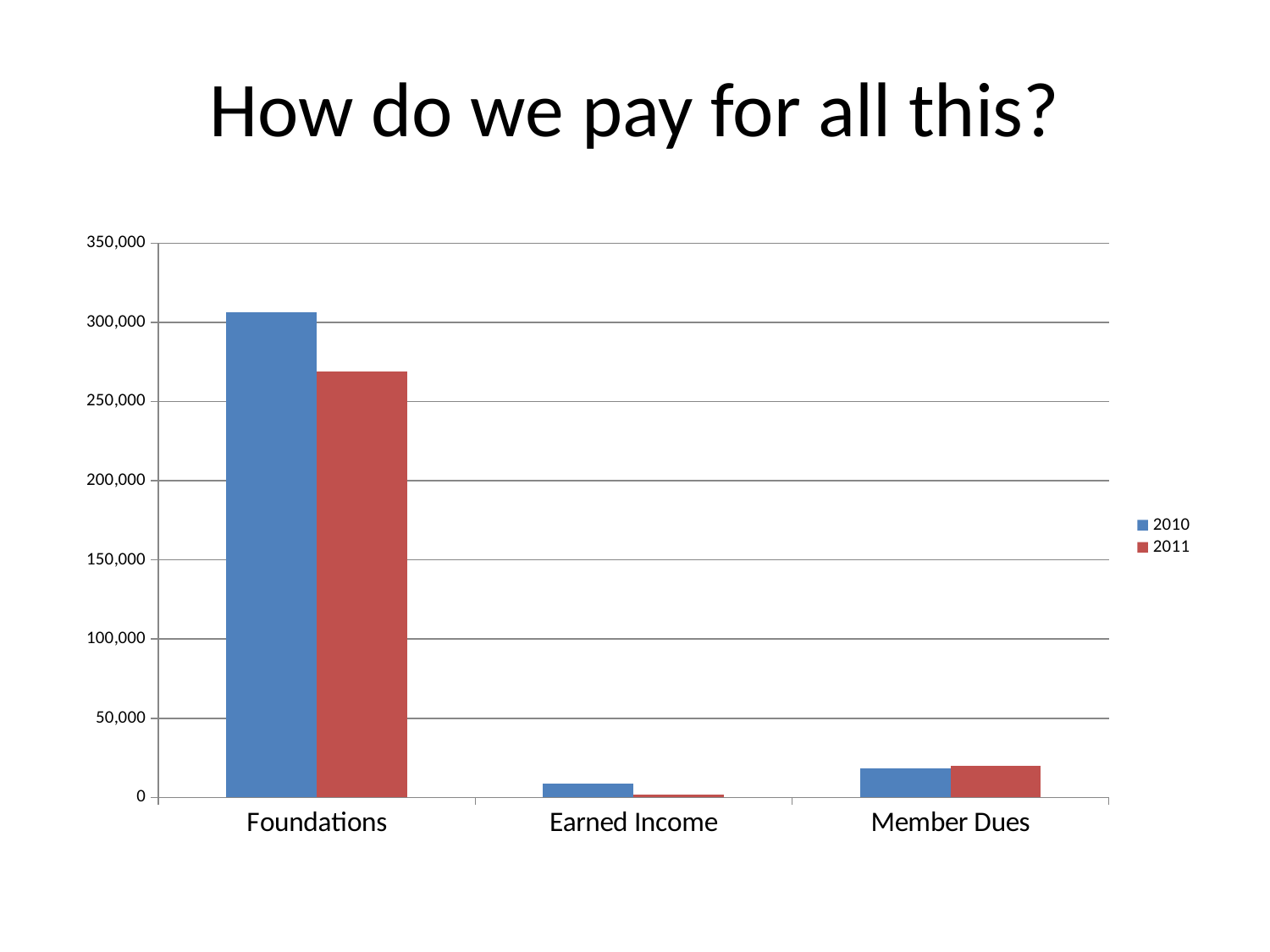
Is the value for Foundations in 2011 greater or less than 250,000? greater What is the title of the slide containing the chart? How do we pay for all this? What kind of chart is shown on the slide? bar chart For Foundations, which year has the larger value, 2010 or 2011? 2010 Is the value for Member Dues in 2011 greater or less than 50,000? less For Earned Income, which year has the larger value, 2010 or 2011? 2010 How many series does the legend list? 2 Which category has the highest value for 2010? Foundations How many categories are shown on the x axis? 3 Is the value for Foundations in 2010 greater or less than 300,000? greater Which category has the lowest value for 2011? Earned Income Which series is shown in red in the legend? 2011